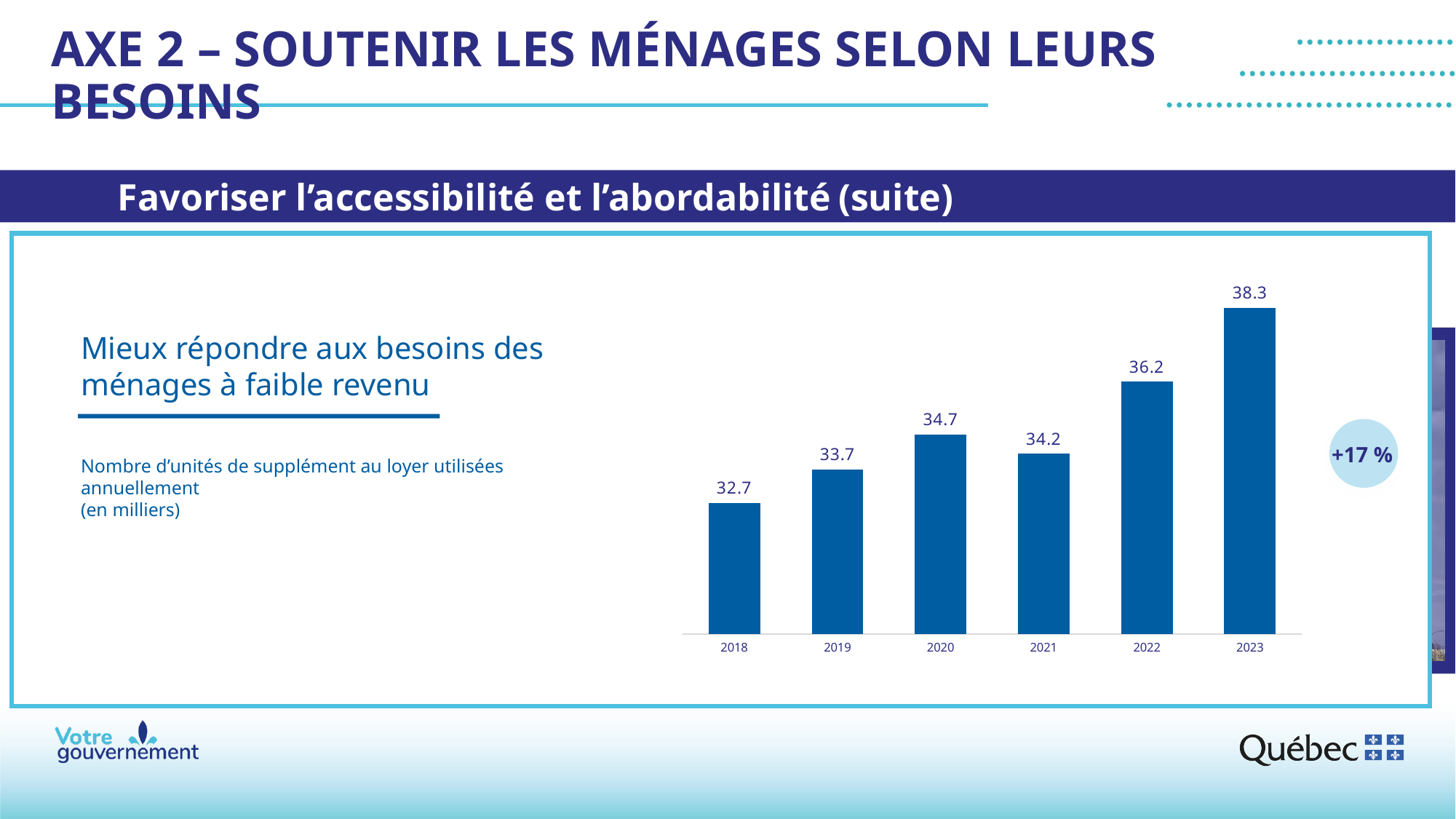
Which year has the highest value? 2023 Do the values generally rise or fall from 2018 to 2023? Rise How many years are shown on the x axis? 6 Which is larger, the value for 2020 or the value for 2021? 2020 What is the value for 2023? 38.3 What is the difference between the values for 2020 and 2021? 0.5 What is the value for 2018? 32.7 What kind of chart is shown? Bar chart Which year has the lowest value? 2018 What percentage change is shown in the circle next to the chart? +17 % What is the difference between the values for 2023 and 2018? 5.6 What is the value for 2021? 34.2